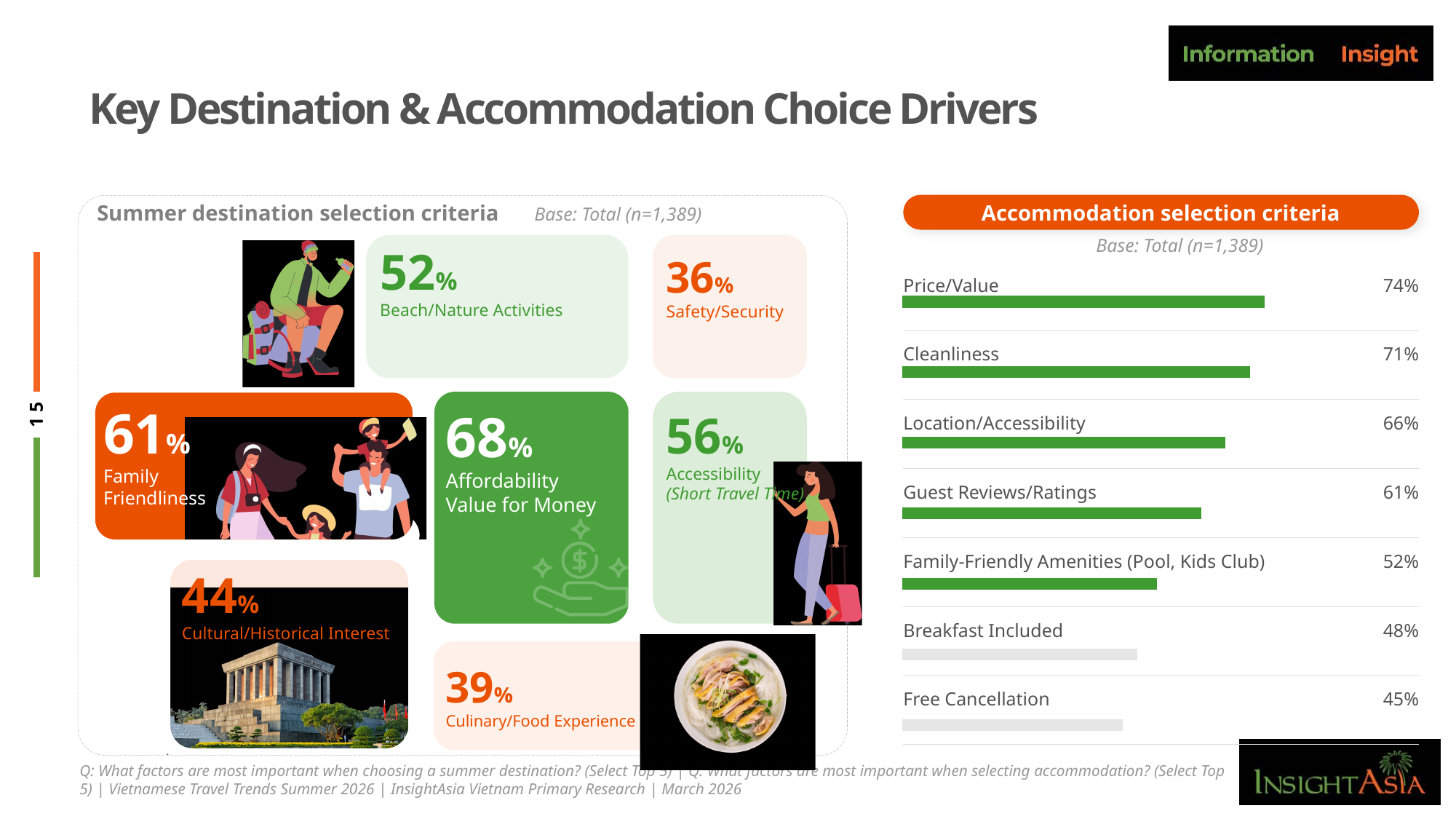
In the Accommodation selection criteria chart, which criterion has the lowest value? Free Cancellation In the Summer destination selection criteria chart, which is larger: Family Friendliness or Accessibility (Short Travel Time)? Family Friendliness In the Summer destination selection criteria chart, which criterion has the lowest value? Safety/Security In the Accommodation selection criteria chart, what is the difference between Cleanliness and Guest Reviews/Ratings? 10% What kind of chart is the Accommodation selection criteria chart? Bar chart In the Accommodation selection criteria chart, what is the value for Price/Value? 74% In the Accommodation selection criteria chart, how many criteria are listed? 7 In the Summer destination selection criteria chart, what is the value for Affordability Value for Money? 68% In the Accommodation selection criteria chart, do the values rise or fall from top to bottom? Fall In the Summer destination selection criteria chart, what is the difference between Beach/Nature Activities and Culinary/Food Experience? 13% In the Accommodation selection criteria chart, what is the value for Breakfast Included? 48% What is the base sample size shown for the Accommodation selection criteria chart? n=1,389